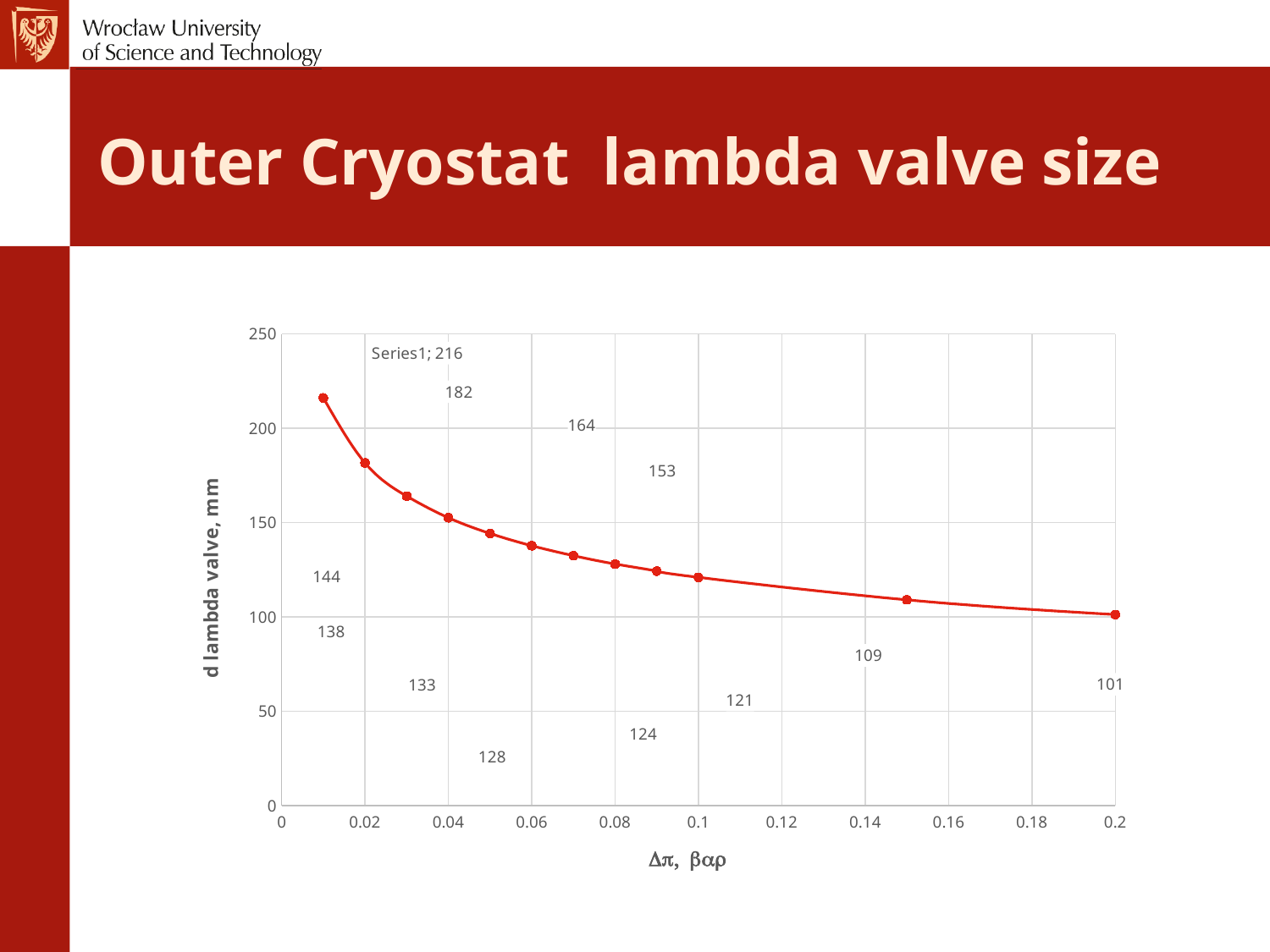
What is the d lambda valve value at Δp = 0.2 bar? 101 Do the values rise or fall as Δp increases along the x axis? fall What is the d lambda valve value at Δp = 0.15 bar? 109 At which Δp value is d lambda valve highest? 0.01 At which Δp value is d lambda valve lowest? 0.2 What is the difference between the d lambda valve values at Δp = 0.01 and Δp = 0.2? 115 What kind of chart is shown on the slide? line chart What is the d lambda valve value at Δp = 0.01 bar? 216 What is the d lambda valve value at Δp = 0.1 bar? 121 Is the value at Δp = 0.04 greater or less than 150? greater How many data points are plotted on the chart? 12 What is the label of the y axis? d lambda valve, mm